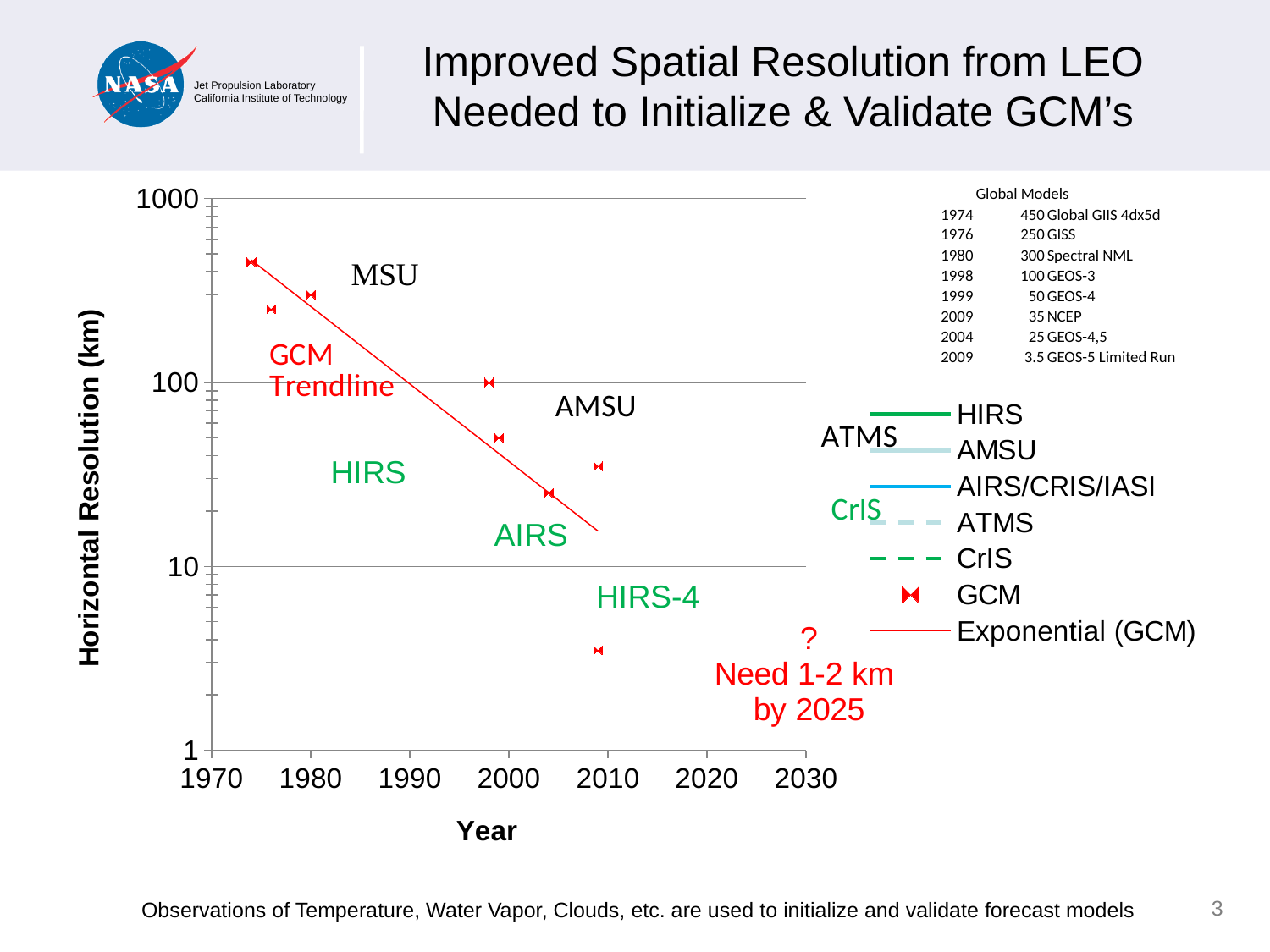
Do the GCM horizontal resolution values rise or fall as the year increases? fall What kind of chart is shown on the slide? scatter chart According to the Global Models list, which year has the highest resolution value? 1974 Is the lowest GCM point plotted at 2009 greater or less than 10 km? less Is the GCM horizontal resolution plotted for 1974 greater or less than 100 km? greater According to the Global Models list, what resolution is given for 1998 (GEOS-3)? 100 Using the Global Models list, what is the difference between the 1980 value (300) and the 1976 value (250)? 50 What is the title of the vertical axis? Horizontal Resolution (km) How many GCM data points are plotted on the chart? 8 According to the Global Models list, which model has the lowest resolution value? GEOS-5 Limited Run What is the title of the horizontal axis? Year How many entries does the chart legend list? 7